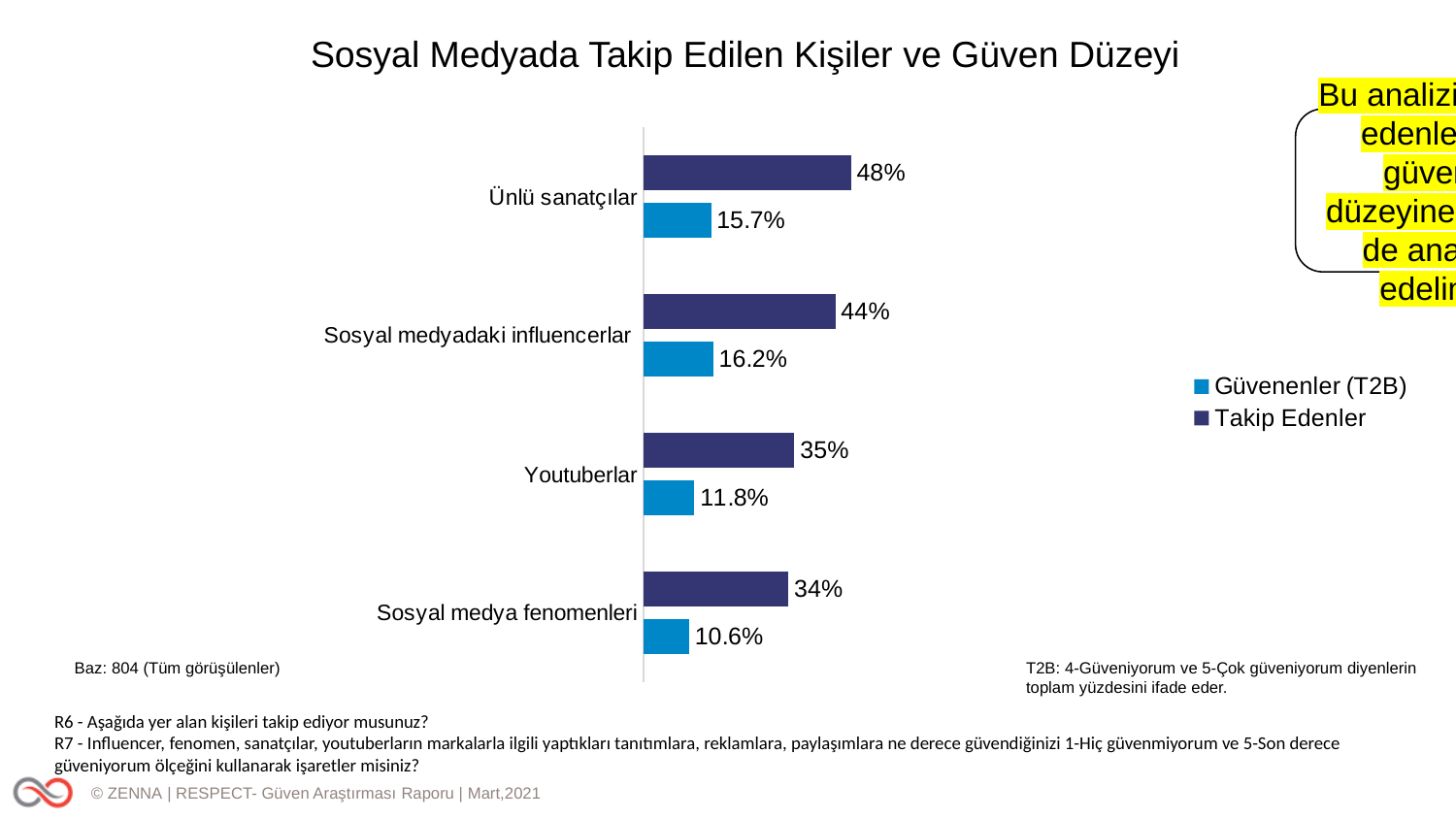
What is the Takip Edenler value for Sosyal medya fenomenleri? 34% What is the title of the chart? Sosyal Medyada Takip Edilen Kişiler ve Güven Düzeyi What kind of chart is shown on the slide? Bar chart What is the Güvenenler (T2B) value for Sosyal medyadaki influencerlar? 16.2% What is the Güvenenler (T2B) value for Youtuberlar? 11.8% How many categories are shown on the chart? 4 What is the Takip Edenler value for Ünlü sanatçılar? 48% Which category has the highest Takip Edenler value? Ünlü sanatçılar What is the difference between the Takip Edenler and Güvenenler (T2B) values for Youtuberlar? 23.2% Which is larger: the Güvenenler (T2B) value for Ünlü sanatçılar or for Sosyal medyadaki influencerlar? Sosyal medyadaki influencerlar Which category has the lowest Güvenenler (T2B) value? Sosyal medya fenomenleri How many series does the legend list? 2